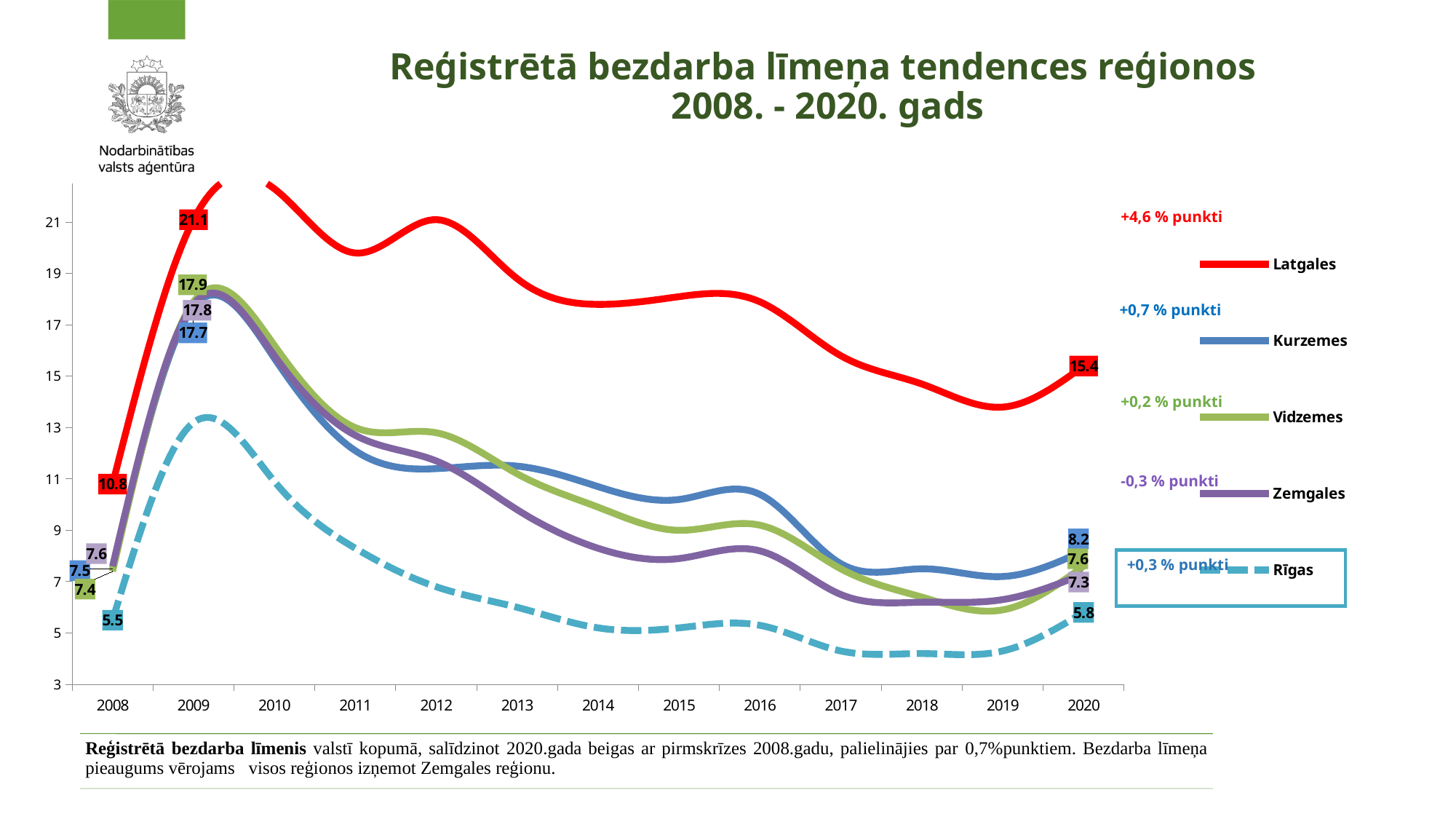
What is the value for Kurzemes in 2008? 7.5 Which series is drawn with a dashed line? Rīgas What is the value for Latgales in 2009? 21.1 Is the value for Rīgas in 2009 greater or less than 11? greater What is the difference between the Latgales values in 2009 and 2020? 5.7 How many years are shown along the x axis? 13 How many series does the legend list? 5 What type of chart is shown on the slide? line chart Which region has the lowest value in 2008? Rīgas Which is larger in 2020, the value for Kurzemes or the value for Zemgales? Kurzemes What is the value for Rīgas in 2020? 5.8 Which region has the highest value in 2020? Latgales